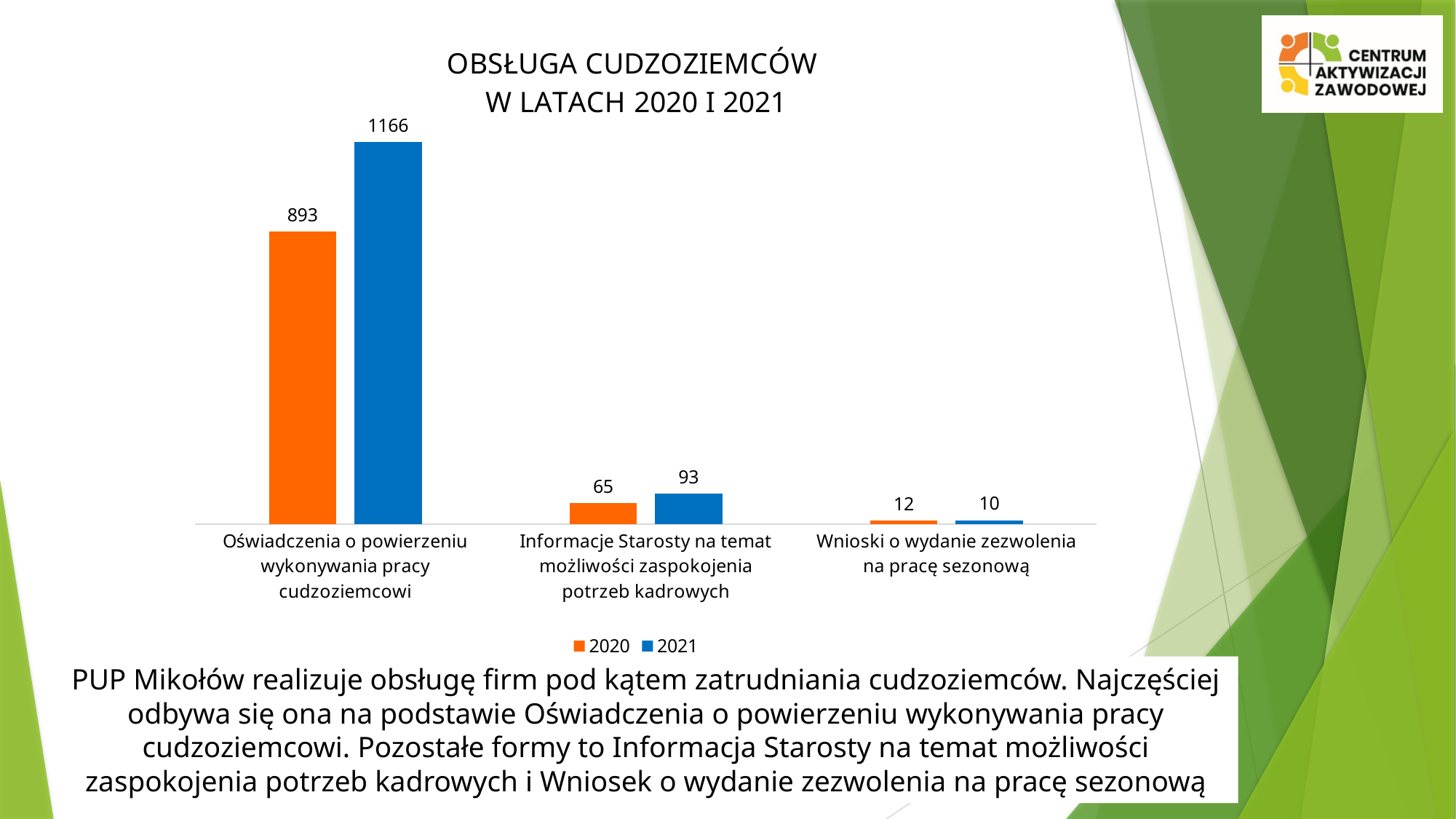
What is the 2021 value for "Wnioski o wydanie zezwolenia na pracę sezonową"? 10 For "Wnioski o wydanie zezwolenia na pracę sezonową", which year has the larger value, 2020 or 2021? 2020 Which colour represents the 2021 series in the legend? Blue What is the difference between the 2021 and 2020 values for "Oświadczenia o powierzeniu wykonywania pracy cudzoziemcowi"? 273 What is the 2021 value for "Oświadczenia o powierzeniu wykonywania pracy cudzoziemcowi"? 1166 What kind of chart is shown on the slide? Bar chart How many categories are shown on the x axis? 3 Which category has the lowest 2021 value? Wnioski o wydanie zezwolenia na pracę sezonową Which category has the highest 2020 value? Oświadczenia o powierzeniu wykonywania pracy cudzoziemcowi What is the 2020 value for "Informacje Starosty na temat możliwości zaspokojenia potrzeb kadrowych"? 65 How many series does the legend list? 2 What is the difference between the 2021 and 2020 values for "Informacje Starosty na temat możliwości zaspokojenia potrzeb kadrowych"? 28